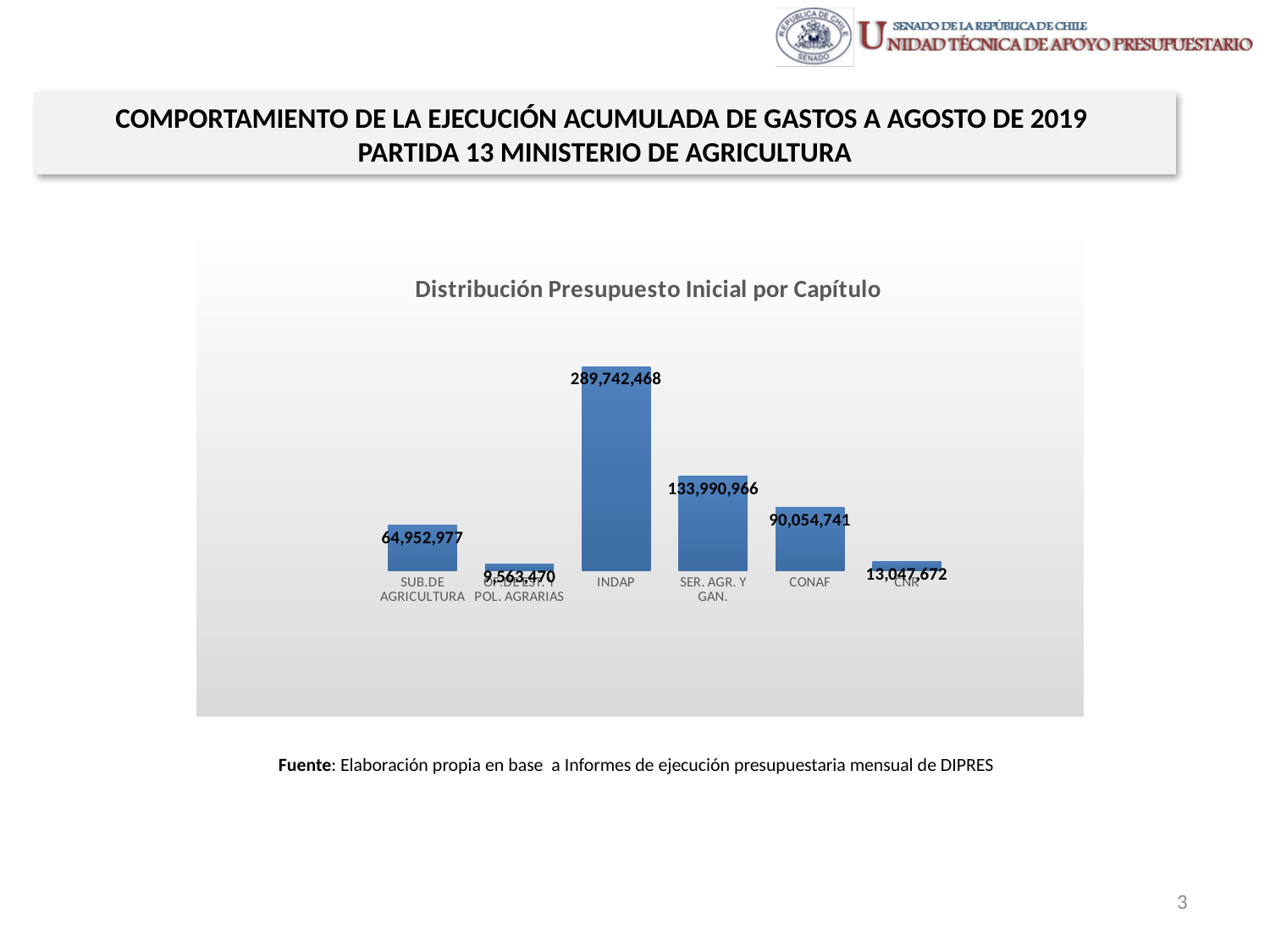
What is the value for SUB.DE AGRICULTURA? 64,952,977 What is the value for CONAF? 90,054,741 What is the difference between the values for INDAP and SER. AGR. Y GAN.? 155,751,502 What is the value for CNR? 13,047,672 What is the value for SER. AGR. Y GAN.? 133,990,966 What is the value for INDAP? 289,742,468 What is the difference between the values for CONAF and SUB.DE AGRICULTURA? 25,101,764 Which category has the highest value? INDAP What kind of chart is shown on the slide? bar chart Which is larger, the value for CONAF or the value for SER. AGR. Y GAN.? SER. AGR. Y GAN. What is the title of the chart? Distribución Presupuesto Inicial por Capítulo How many categories are shown in the chart? 6